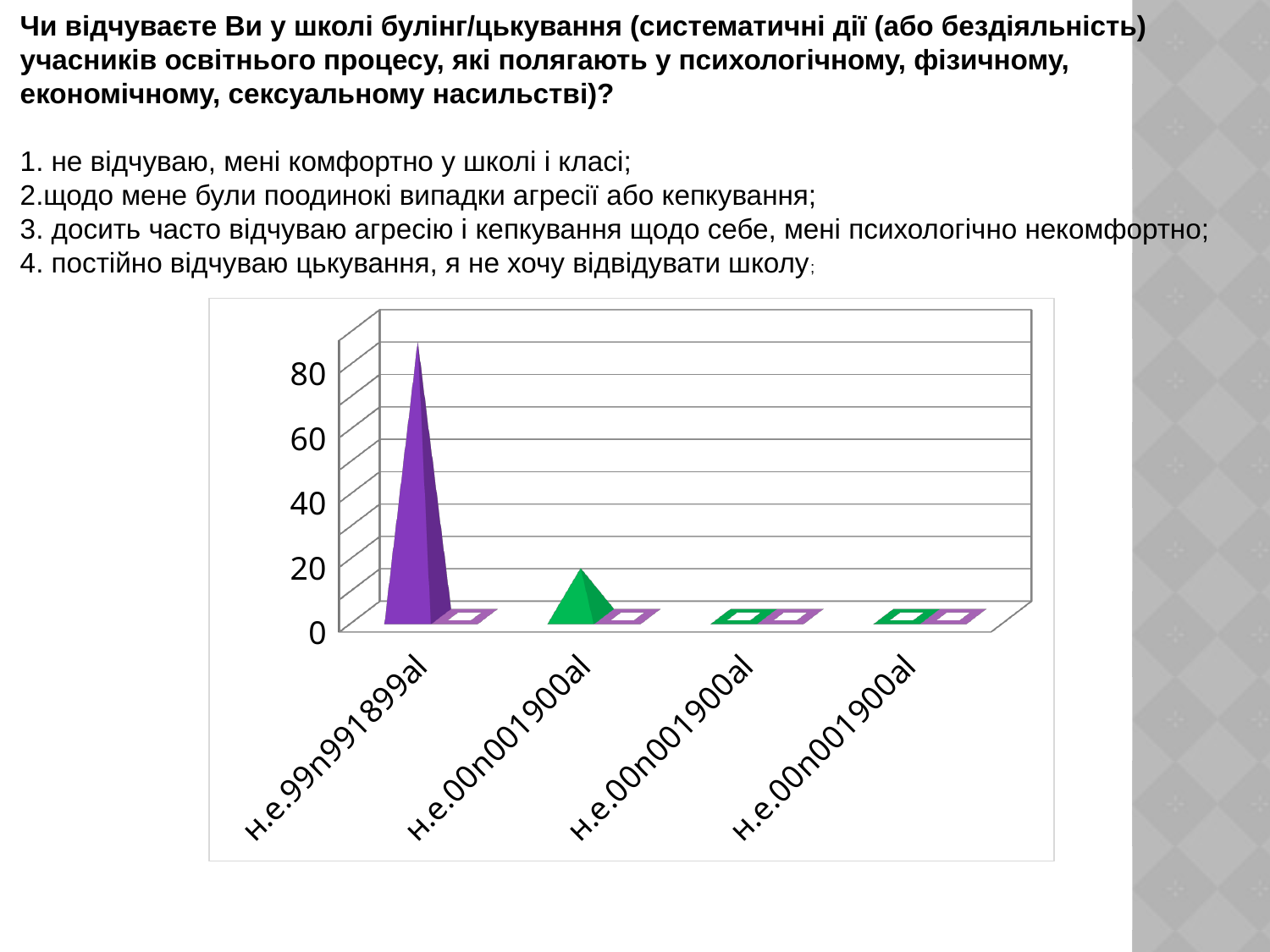
Which is larger: the value for the first category or the value for the second category? the first category Is the value of the tallest bar (first category) greater or less than 60? greater Which category position has the highest value in the chart? the first (leftmost) category What kind of chart is shown on the slide? bar chart Is the value of the green bar in the second category greater or less than 20? less Do the values rise or fall moving from left to right along the x axis? fall What is the highest tick value shown on the vertical axis? 80 What colour is the tallest bar in the chart? purple Is the value of the bar in the third category greater or less than 20? less How many categories are shown along the x axis of the chart? 4